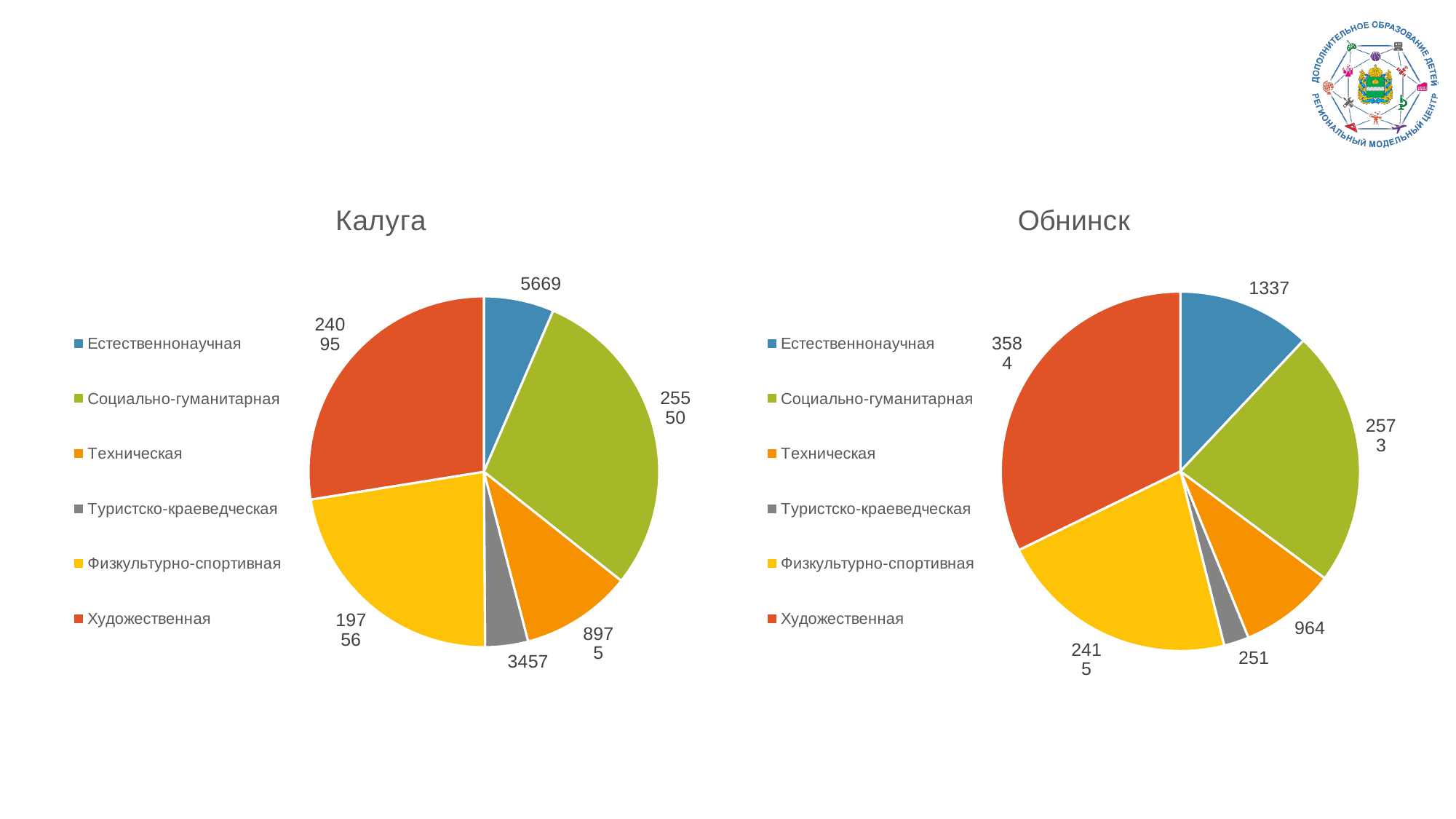
How many categories does the legend of the Обнинск chart list? 6 In the Калуга chart, what is the value for Естественнонаучная? 5669 In the Обнинск chart, what is the value for Туристско-краеведческая? 251 In the Обнинск chart, what is the value for Естественнонаучная? 1337 In the Обнинск chart, which category has the smallest slice? Туристско-краеведческая In the Калуга chart, what is the difference between the values for Естественнонаучная and Туристско-краеведческая? 2212 What type of chart is used for the Калуга data? pie chart In the Обнинск chart, what is the value for Техническая? 964 In the Калуга chart, what is the value for Туристско-краеведческая? 3457 In the Обнинск chart, which is larger: Естественнонаучная or Техническая? Естественнонаучная In the Обнинск chart, which category has the largest slice? Художественная In the Калуга chart, which category has the smallest slice? Туристско-краеведческая